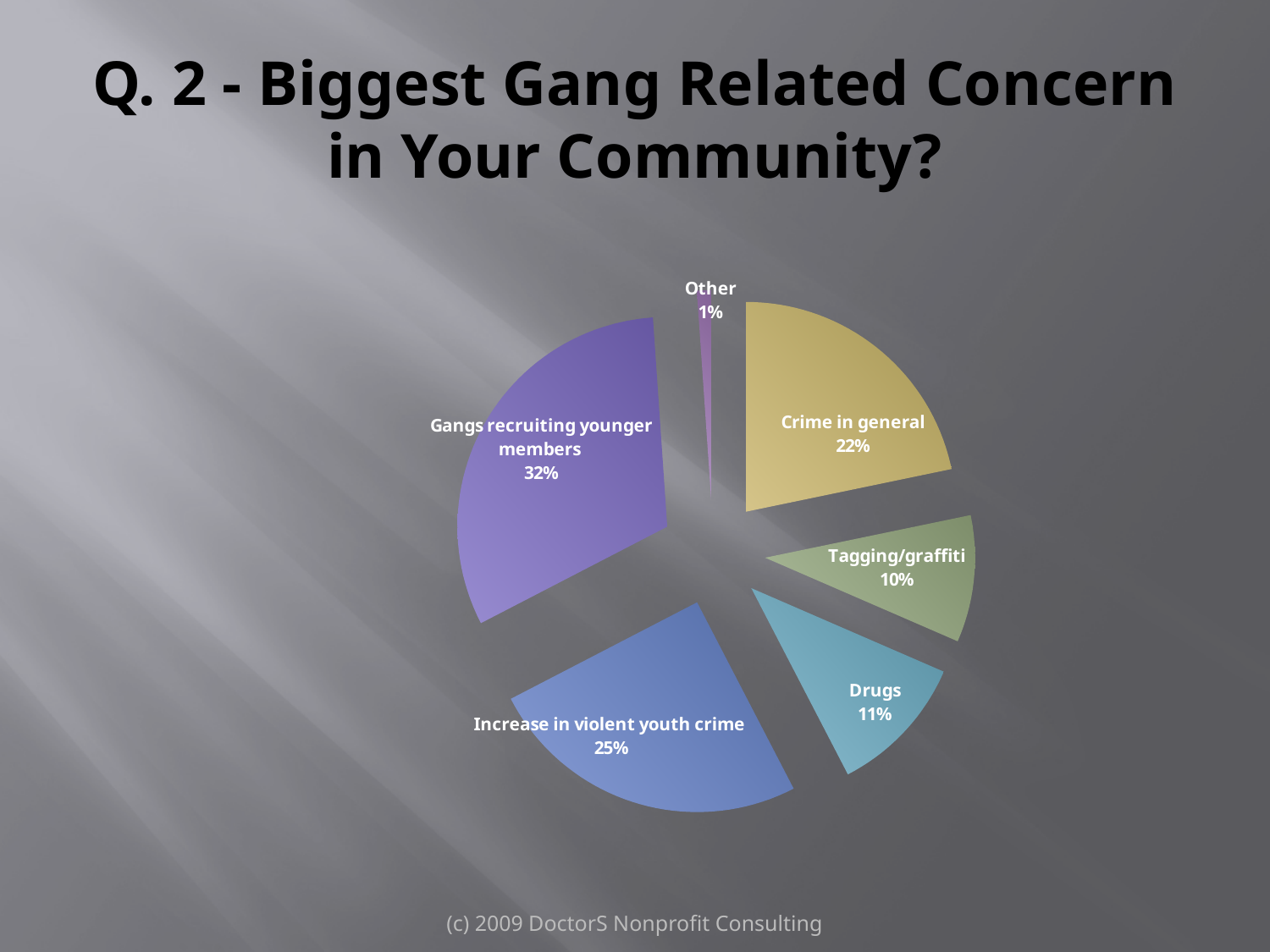
Which category has the largest slice of the pie? Gangs recruiting younger members What is the title of the slide containing the chart? Q. 2 - Biggest Gang Related Concern in Your Community? What is the value shown for 'Drugs'? 11% What share of the pie is 'Crime in general'? 22% Which is larger, 'Crime in general' or 'Increase in violent youth crime'? Increase in violent youth crime What percentage is shown for 'Tagging/graffiti'? 10% What is the difference in percentage points between 'Gangs recruiting younger members' and 'Increase in violent youth crime'? 7 How many categories are shown in the pie chart? 6 What percentage of respondents chose 'Gangs recruiting younger members' as their biggest gang related concern? 32% What is the combined percentage of 'Drugs' and 'Tagging/graffiti'? 21% What kind of chart is shown on the slide? pie chart Which category has the smallest slice of the pie? Other